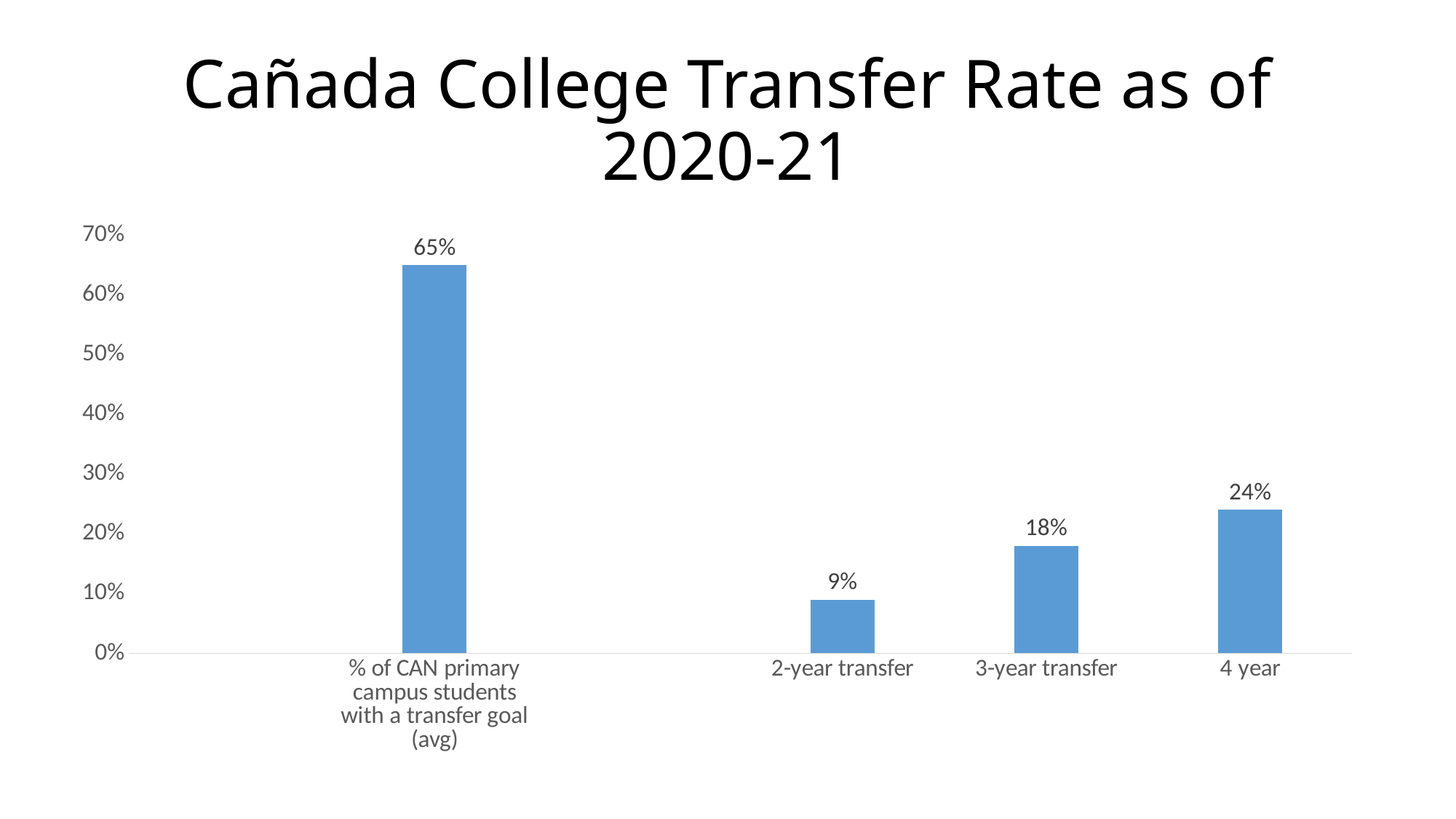
What kind of chart is shown on the slide? bar chart Is the value for 4 year greater or less than 30%? less Which category has the highest value? % of CAN primary campus students with a transfer goal (avg) Which category has the lowest value? 2-year transfer What is the value for 2-year transfer? 9% What is the difference between the 4 year value and the 2-year transfer value? 15% What is the value for 3-year transfer? 18% How many bars are shown in the chart? 4 Which is larger, the value for 3-year transfer or the value for 4 year? 4 year What is the value for % of CAN primary campus students with a transfer goal (avg)? 65% What is the value for 4 year? 24% What is the difference between the 3-year transfer value and the 2-year transfer value? 9%